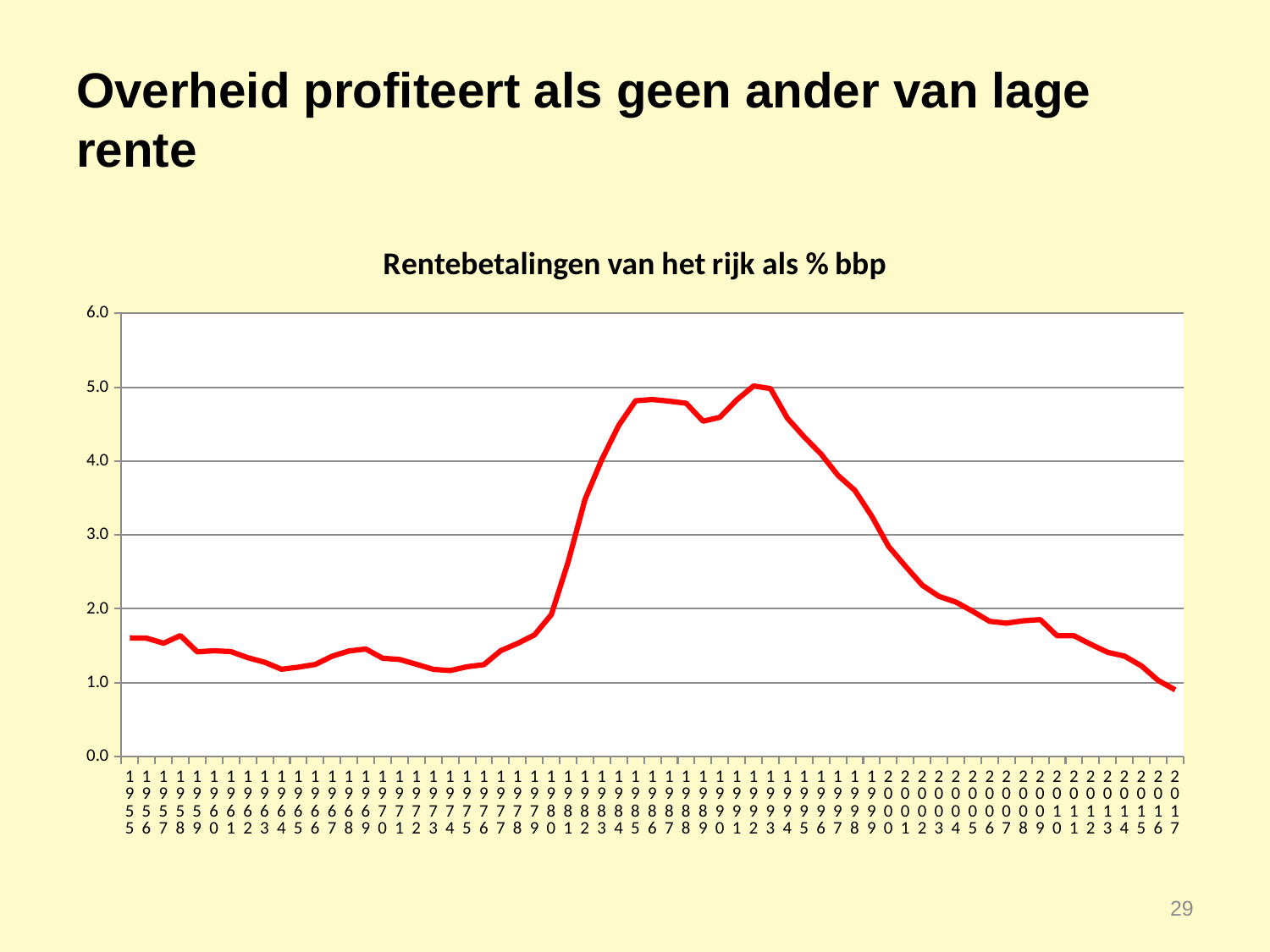
What colour is the plotted line? red How many years (data points) are plotted along the x axis? 63 In which year does the line reach its lowest value? 2017 Is the value for 1985 greater or less than 4.0? greater In which year does the line reach its highest value? 1992 Is the value for 2010 greater or less than 2.0? less What is the title of the chart? Rentebetalingen van het rijk als % bbp Do the values rise or fall between 1992 and 2017? fall Which year has the larger value, 1975 or 1985? 1985 What kind of chart is shown on the slide? line chart Is the value for 1970 greater or less than 1.0? greater